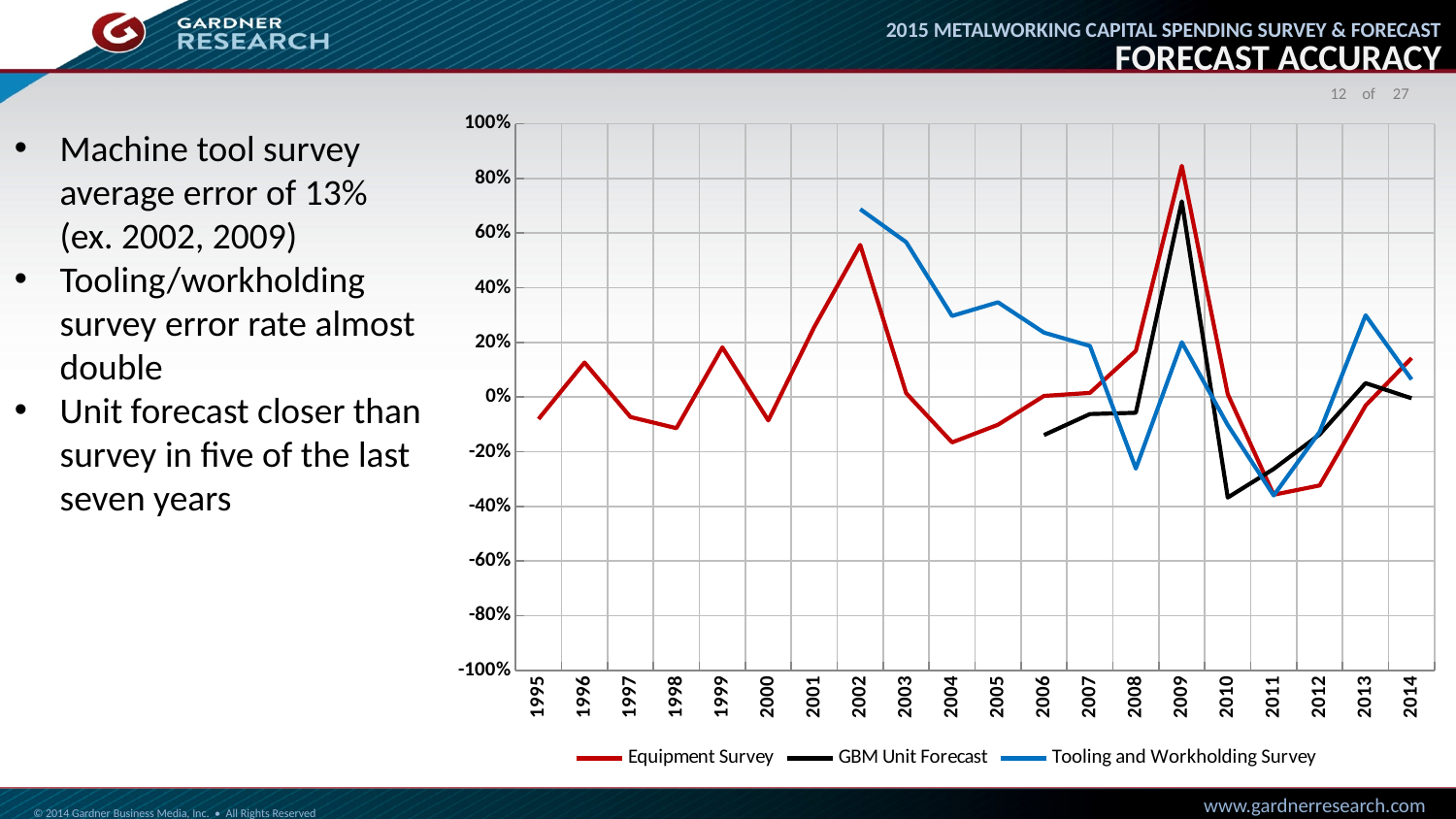
How many years are shown on the x axis of the chart? 20 In which year does the Equipment Survey series reach its highest value? 2009 In which year does the Tooling and Workholding Survey series reach its highest value? 2002 Does the Equipment Survey series rise or fall from 2010 to 2011? fall In 2013, which is larger: the Tooling and Workholding Survey value or the Equipment Survey value? Tooling and Workholding Survey Is the Tooling and Workholding Survey value for 2008 greater or less than -20%? less In 2009, which is larger: the Equipment Survey value or the GBM Unit Forecast value? Equipment Survey Is the Equipment Survey value for 2002 greater or less than 40%? greater How many series does the chart legend list? 3 What kind of chart is shown on the slide? line chart Is the Tooling and Workholding Survey value for 2013 greater or less than 20%? greater